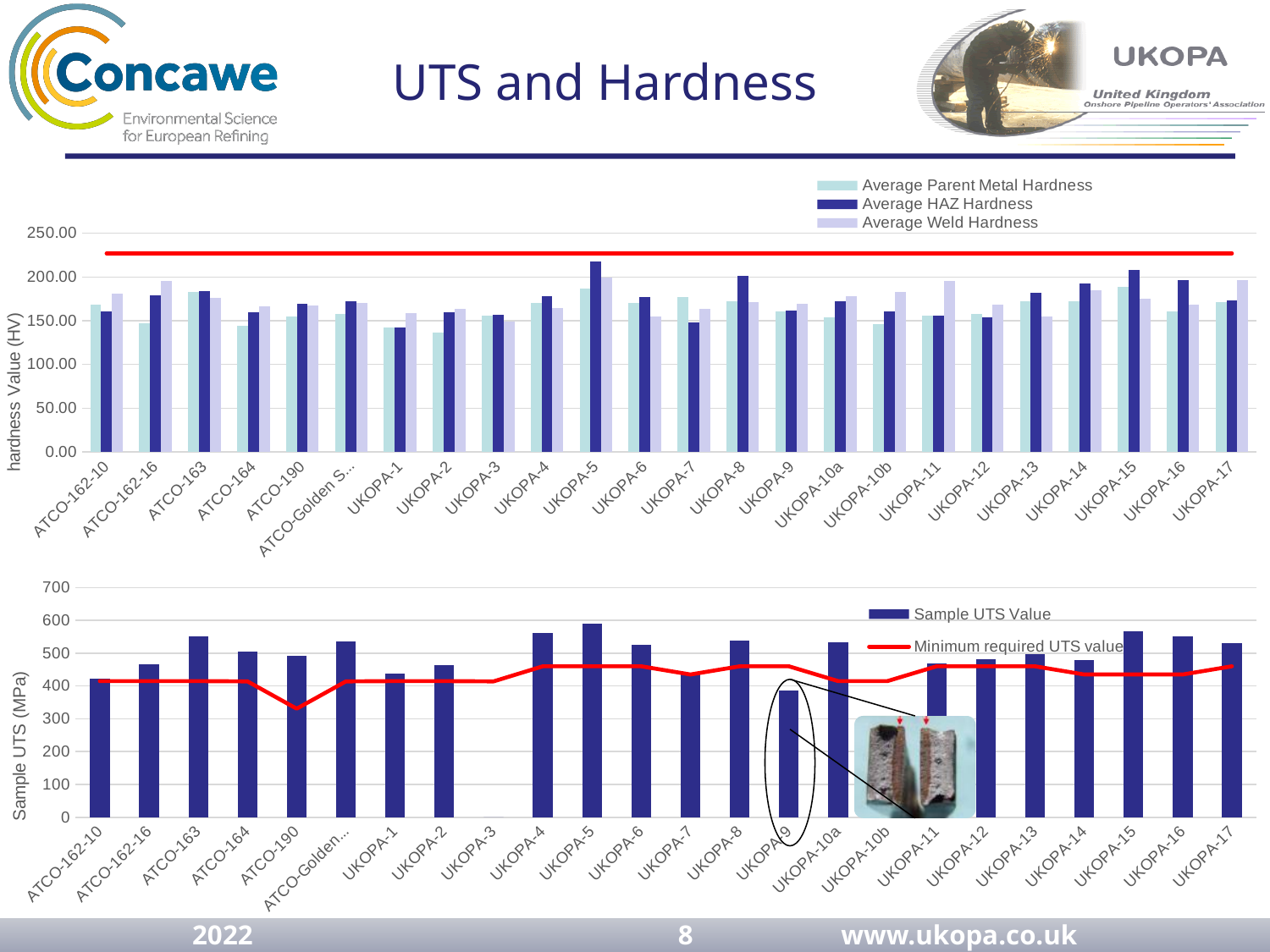
How many entries does the legend of the bottom (UTS) chart list? 2 How many categories are shown on the x axis of the top (hardness) chart? 24 In the bottom (UTS) chart, which category has the lowest Sample UTS Value bar? UKOPA-9 In the top (hardness) chart, which is larger: the Average HAZ Hardness for UKOPA-8 or for UKOPA-9? UKOPA-8 In the top (hardness) chart, is the Average Parent Metal Hardness for UKOPA-2 greater or less than 150.00? less In the top (hardness) chart, which category has the highest Average HAZ Hardness bar? UKOPA-5 How many series does the legend of the top (hardness) chart list? 3 What is the y-axis label of the top chart? hardness Value (HV) In the top (hardness) chart, is the Average HAZ Hardness for UKOPA-5 greater or less than 200.00? greater In the bottom (UTS) chart, which is larger: the Sample UTS Value for UKOPA-5 or for UKOPA-9? UKOPA-5 In the bottom (UTS) chart, is the Sample UTS Value for ATCO-163 greater or less than 500? greater What kind of chart is the top chart on the slide? combination bar and line chart